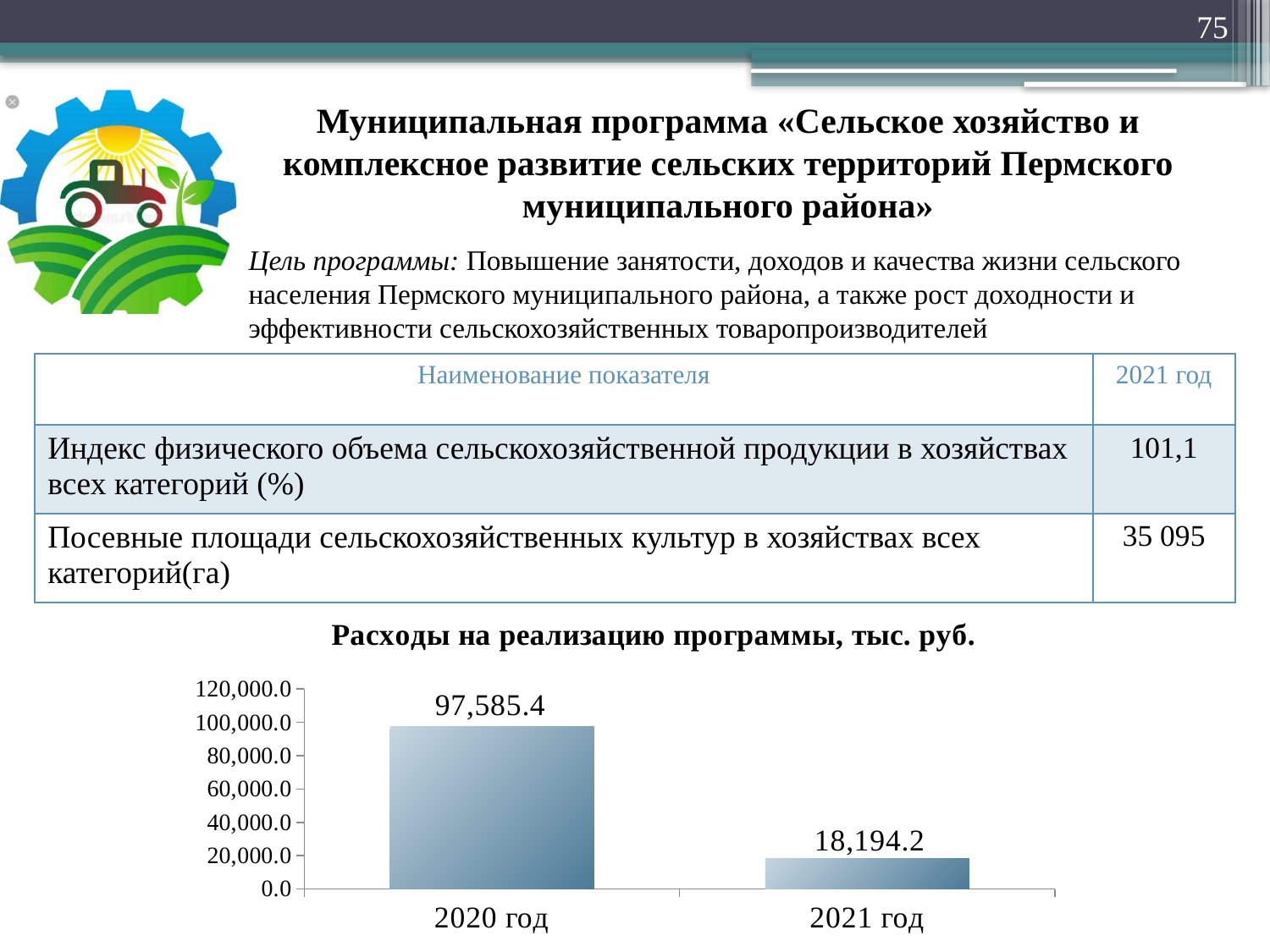
What is the difference between the values for 2020 год and 2021 год? 79,391.2 What is the value for 2021 год in the chart? 18,194.2 Which year has the highest value in the chart? 2020 год Which is larger, the value for 2020 год or the value for 2021 год? 2020 год What is the value for 2020 год in the chart? 97,585.4 Is the value for 2020 год greater or less than 80,000.0? greater Is the value for 2021 год greater or less than 20,000.0? less How many categories are shown on the x axis of the chart? 2 What kind of chart is shown on the slide? bar chart Do the values rise or fall from 2020 год to 2021 год? fall What is the title of the chart? Расходы на реализацию программы, тыс. руб. Which year has the lowest value in the chart? 2021 год